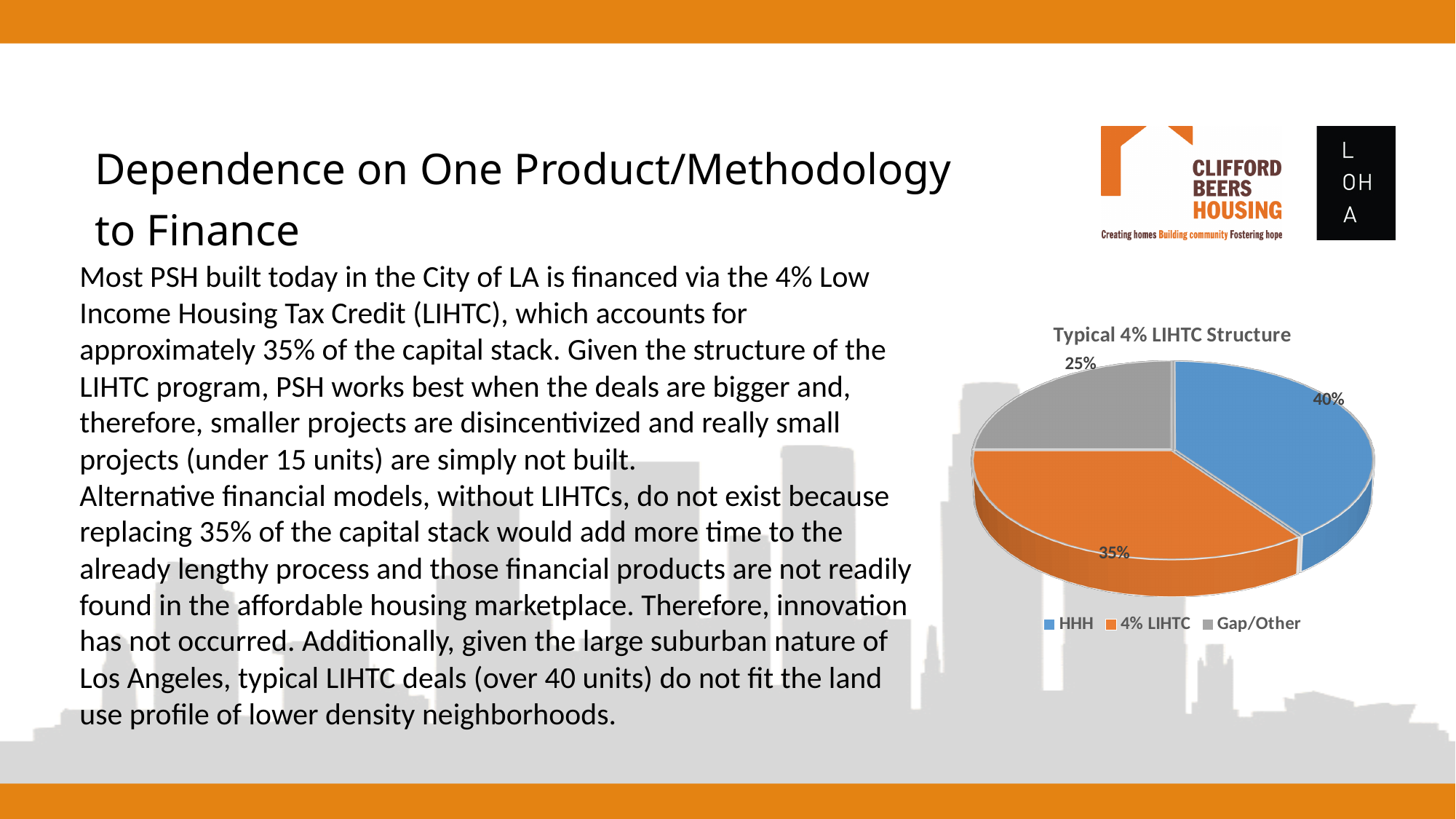
What share of the pie does Gap/Other represent? 25% What is the difference between the HHH share and the Gap/Other share? 15% How many entries does the legend list? 3 Which slice of the pie is the largest? HHH What share of the pie does HHH represent? 40% What kind of chart is shown on the slide? Pie chart What is the title of the chart? Typical 4% LIHTC Structure What share of the pie does 4% LIHTC represent? 35% How many slices does the pie chart have? 3 Which is larger, the 4% LIHTC slice or the Gap/Other slice? 4% LIHTC What colour is the 4% LIHTC slice? Orange Which slice of the pie is the smallest? Gap/Other